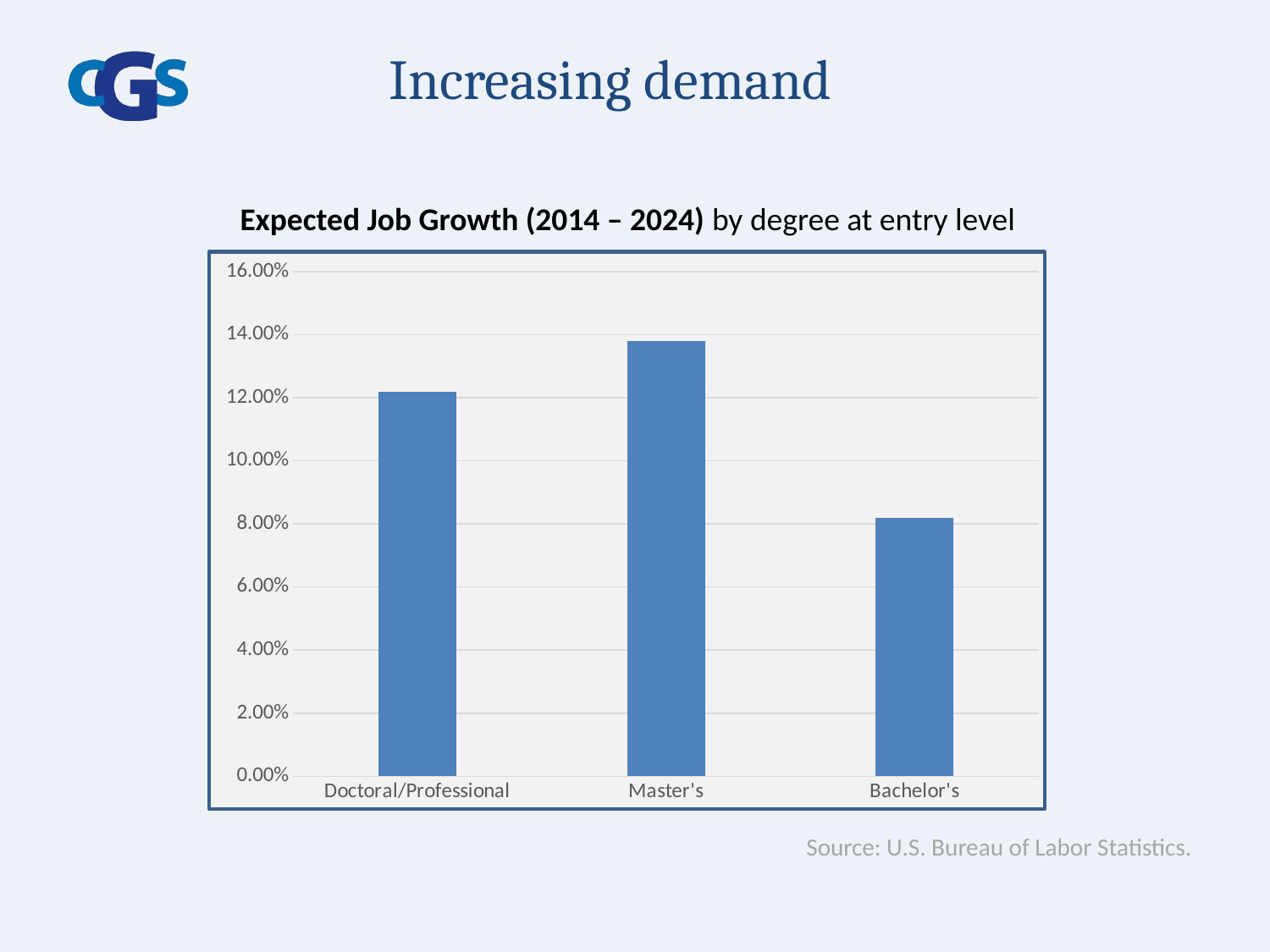
Is the value for Bachelor's greater or less than 10.00%? less Which degree category has the lowest expected job growth? Bachelor's What is the highest value shown on the y axis of the chart? 16.00% Which degree category has the highest expected job growth? Master's Which has a higher expected job growth, Master's or Doctoral/Professional? Master's Which has a higher expected job growth, Doctoral/Professional or Bachelor's? Doctoral/Professional Is the value for Master's greater or less than 12.00%? greater Is the value for Doctoral/Professional greater or less than 14.00%? less How many degree categories are shown on the x axis of the chart? 3 What is the title of the chart? Expected Job Growth (2014 – 2024) by degree at entry level What kind of chart is shown on the slide? bar chart